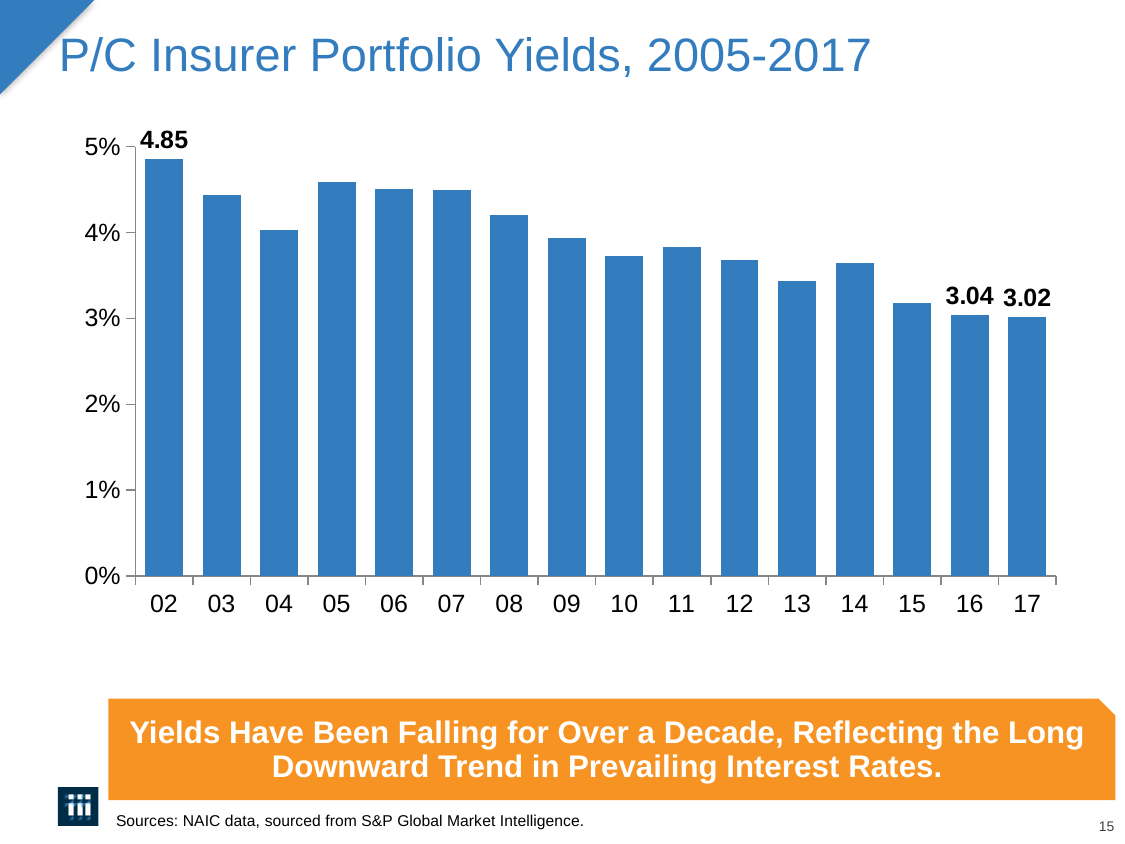
What kind of chart is shown on the slide? bar chart Is the value for 05 greater or less than 4%? greater What is the difference between the yield for 02 and the yield for 17? 1.83 Is the value for 13 greater or less than 4%? less What is the portfolio yield shown for 17? 3.02 Which year has the larger yield, 16 or 17? 16 Which year has the lowest portfolio yield? 17 Do the yields generally rise or fall from 02 to 17? fall What is the portfolio yield shown for 02? 4.85 How many years are shown on the x axis? 16 Which year has the highest portfolio yield? 02 What is the portfolio yield shown for 16? 3.04